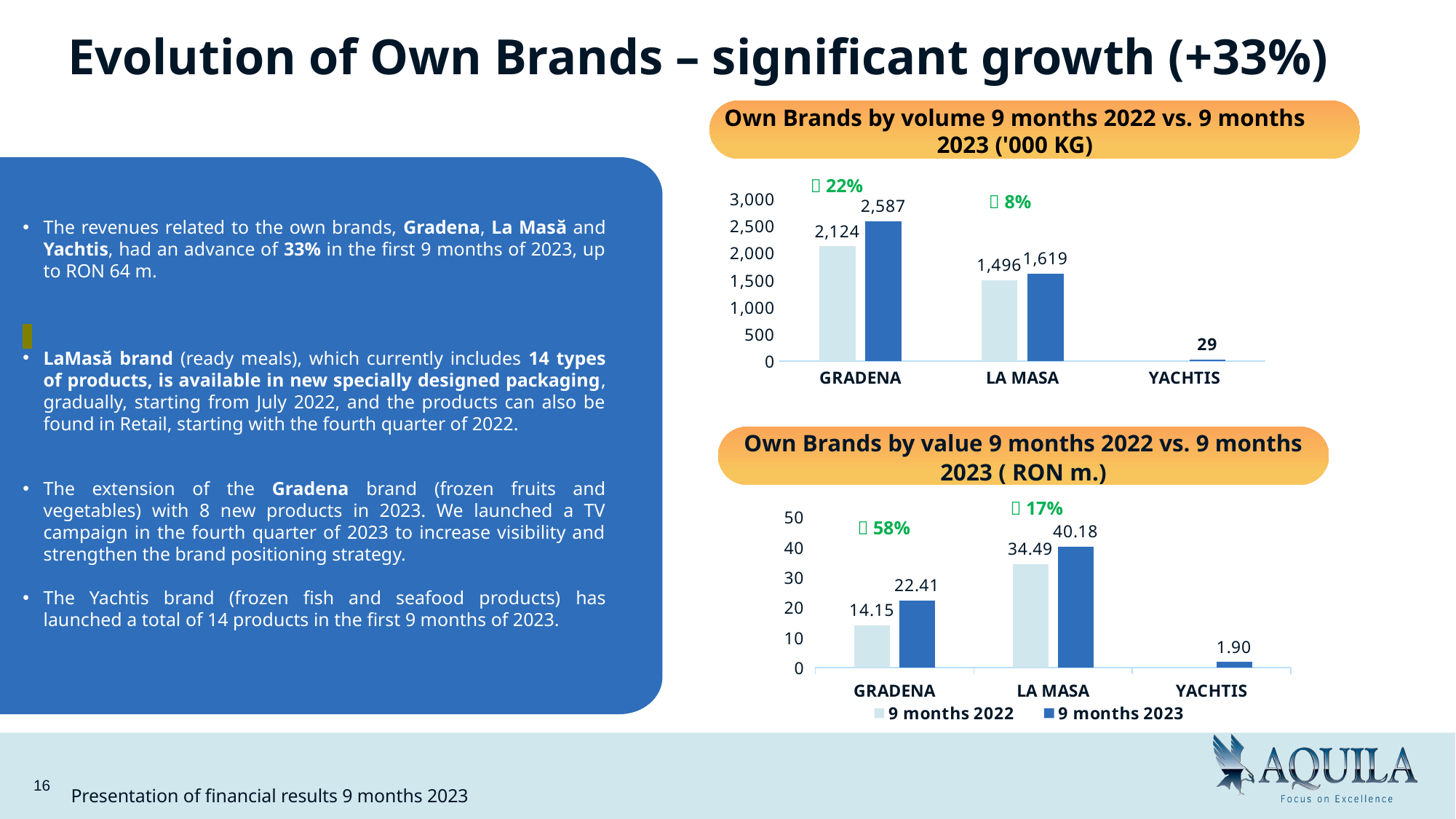
In the 'Own Brands by volume' chart, what is the 9 months 2023 value for GRADENA? 2,587 In the 'Own Brands by volume' chart, which brand has the lowest volume? YACHTIS What type of chart is the 'Own Brands by volume' chart? Bar chart In the 'Own Brands by volume' chart, what is the 9 months 2022 value for LA MASA? 1,496 How many series does the legend of the 'Own Brands by value' chart list? 2 In the 'Own Brands by value' chart, what is the difference between the 9 months 2023 and 9 months 2022 values for LA MASA? 5.69 In the 'Own Brands by value' chart, which is larger: the 9 months 2023 value for GRADENA or the 9 months 2022 value for LA MASA? 9 months 2022 value for LA MASA In the 'Own Brands by value' chart, which brand has the highest 9 months 2023 value? LA MASA In the 'Own Brands by value' chart, what is the 9 months 2023 value for LA MASA? 40.18 In the 'Own Brands by volume' chart, what value is labelled for YACHTIS? 29 In the 'Own Brands by volume' chart, what is the difference between the 9 months 2023 and 9 months 2022 values for GRADENA? 463 In the 'Own Brands by value' chart, what is the 9 months 2022 value for GRADENA? 14.15